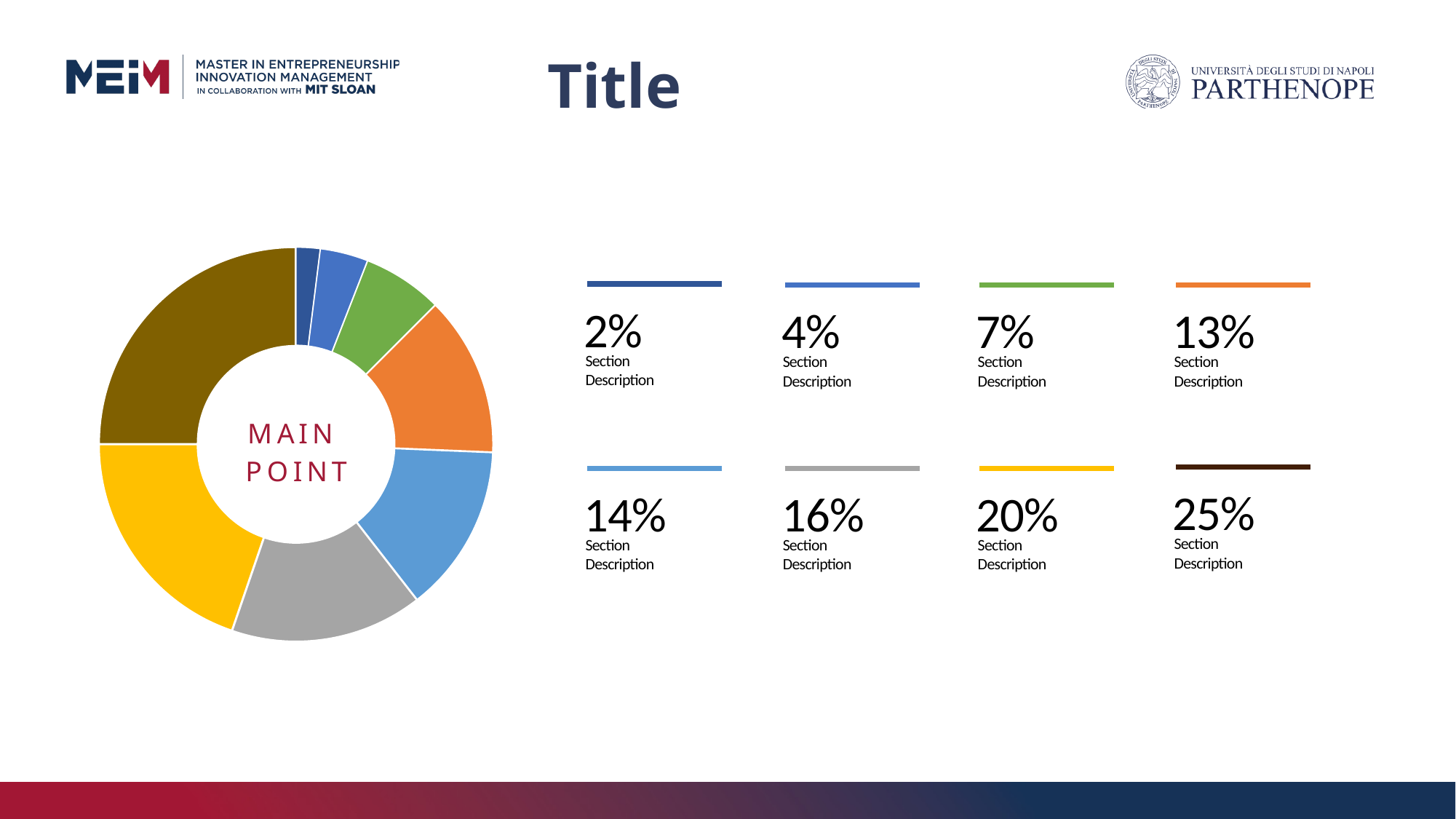
How many slices does the donut chart have? 8 What percentage is shown for the yellow slice of the donut chart? 20% What percentage is shown for the gray slice of the donut chart? 16% Which slice is larger in the donut chart, the gray slice or the green slice? The gray slice What is the largest percentage shown for a slice of the donut chart? 25% What text is written in the centre of the donut chart? MAIN POINT What colour is the largest slice (25%) of the donut chart? Dark brown What is the smallest percentage shown for a slice of the donut chart? 2% What kind of chart is shown on the slide? Pie (donut) chart What percentage is shown for the green slice of the donut chart? 7% What is the difference between the largest slice (25%) and the smallest slice (2%) of the donut chart? 23% What percentage is shown for the orange slice of the donut chart? 13%